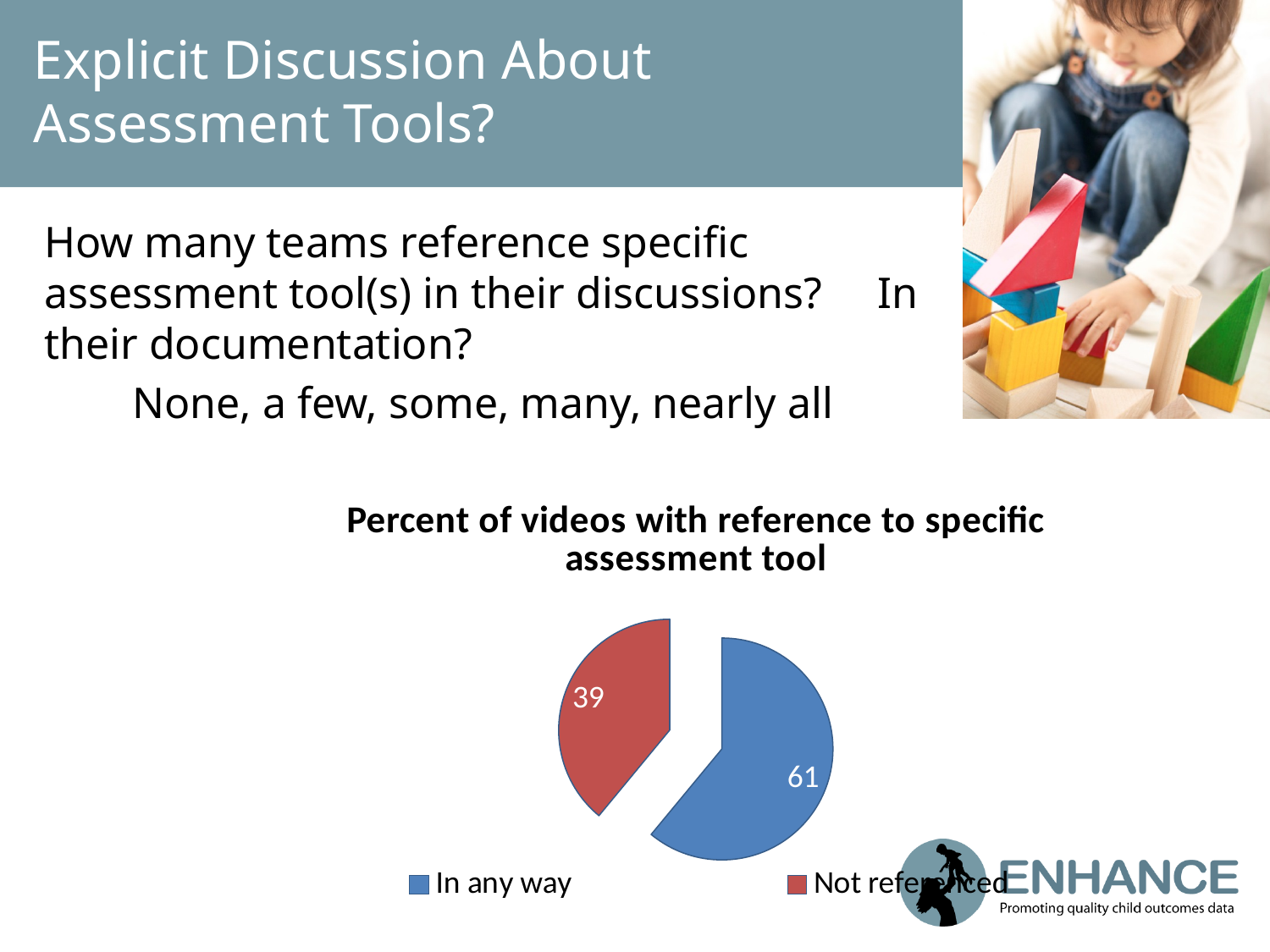
Which slice is the largest? In any way What is the value for "In any way"? 61 How many entries does the legend list? 2 What is the difference between the "In any way" and "Not referenced" values? 22 What is the total of the two slice values? 100 What is the value for "Not referenced"? 39 What colour is the "Not referenced" slice? red What is the title of the chart? Percent of videos with reference to specific assessment tool What kind of chart is shown on the slide? pie chart How many slices does the pie chart have? 2 Which is larger, "In any way" or "Not referenced"? In any way Which slice is the smallest? Not referenced